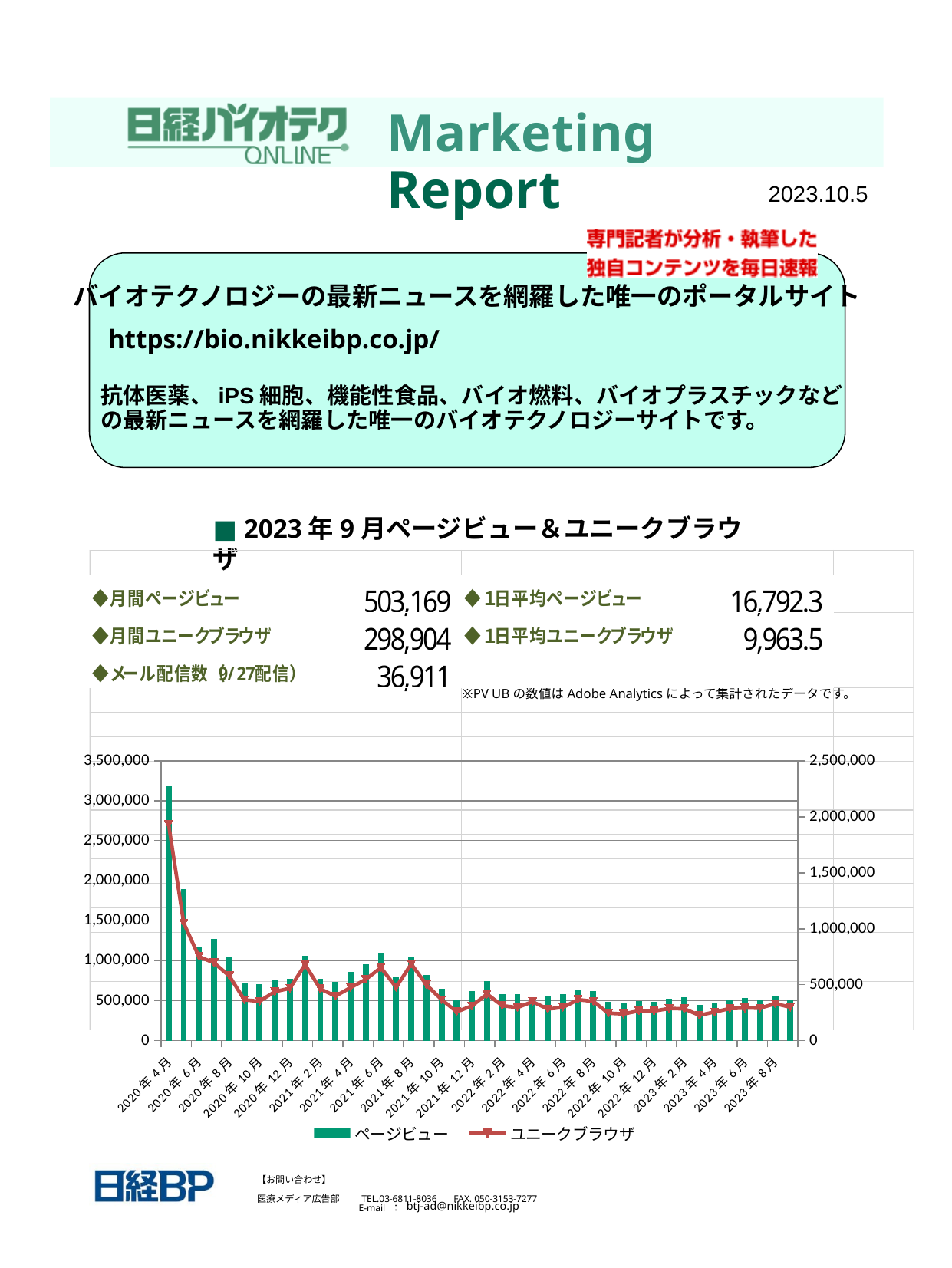
Which month has the highest ページビュー bar? 2020年4月 Is the ページビュー value for 2020年6月 greater or less than 1,500,000? less Do the ユニークブラウザ values generally rise or fall from 2020年4月 to 2020年10月? fall Is the ユニークブラウザ value for 2020年4月 greater or less than 1,500,000 on the right axis? greater How many series does the chart legend list? 2 What kind of chart is shown on the slide? A bar chart combined with a line chart Do the ページビュー values generally rise or fall from 2020年4月 to 2023年8月? fall Is the ページビュー value for 2023年8月 greater or less than 1,000,000? less Which has the larger ページビュー value, 2020年4月 or 2021年6月? 2020年4月 What are the two series named in the chart legend? ページビュー and ユニークブラウザ What is the title printed above the chart? 2023年9月ページビュー＆ユニークブラウザ